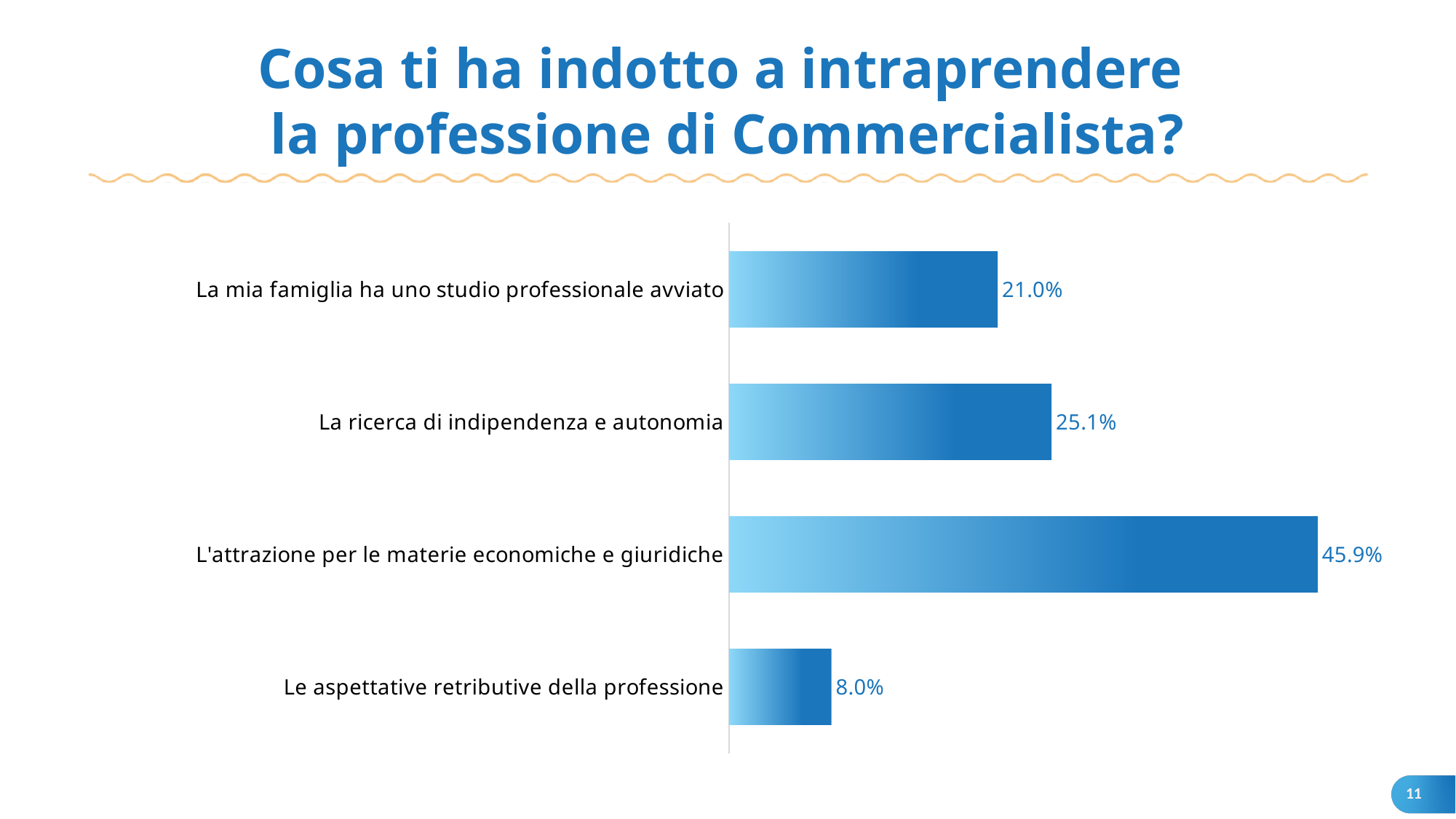
What is the title of the slide? Cosa ti ha indotto a intraprendere la professione di Commercialista? What kind of chart is shown on the slide? Bar chart What is the difference between the values for "L'attrazione per le materie economiche e giuridiche" and "La ricerca di indipendenza e autonomia"? 20.8% What is the value for "Le aspettative retributive della professione"? 8.0% What is the value for "L'attrazione per le materie economiche e giuridiche"? 45.9% What is the value for "La mia famiglia ha uno studio professionale avviato"? 21.0% What is the value for "La ricerca di indipendenza e autonomia"? 25.1% Which is larger: the value for "La ricerca di indipendenza e autonomia" or the value for "La mia famiglia ha uno studio professionale avviato"? La ricerca di indipendenza e autonomia What is the difference between the values for "La mia famiglia ha uno studio professionale avviato" and "Le aspettative retributive della professione"? 13.0% How many categories are shown in the chart? 4 Which category has the highest value? L'attrazione per le materie economiche e giuridiche Which category has the lowest value? Le aspettative retributive della professione